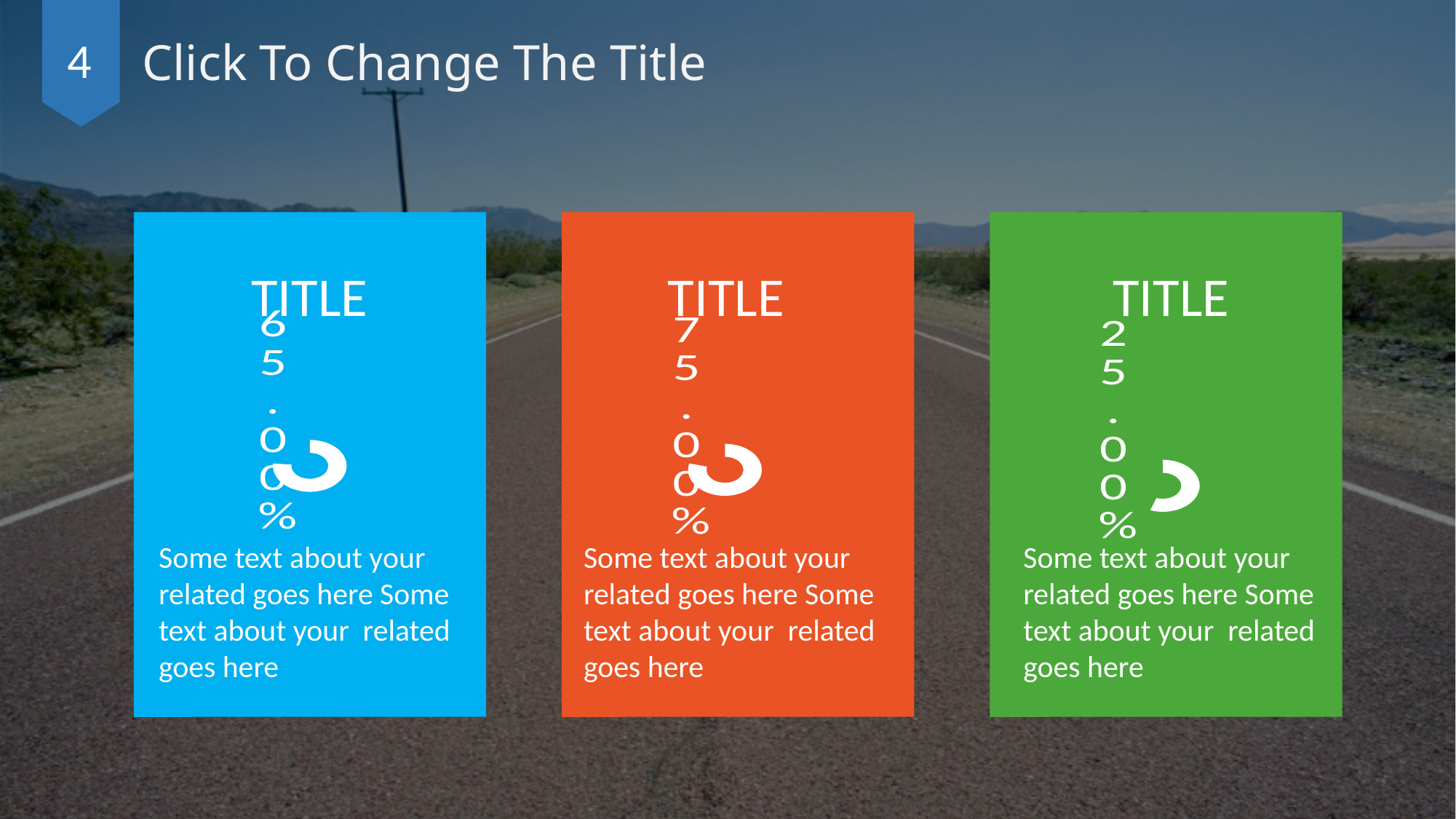
Which panel's chart shows the highest percentage? The middle (orange) panel What value is shown on the left (blue) panel's chart? 65.00% Which panel's chart shows the lowest percentage? The right (green) panel What colour is the background of the panel containing the 75.00% chart? Orange What is the difference between the middle (orange) panel's value and the left (blue) panel's value? 10.00% Is the value on the right (green) panel's chart greater or less than 50%? less What value is shown on the right (green) panel's chart? 25.00% What value is shown on the middle (orange) panel's chart? 75.00% How many charts are shown on the slide? 3 What is the difference between the middle (orange) panel's value and the right (green) panel's value? 50.00% What kind of chart is used in each panel? Doughnut chart Which is larger, the value on the left (blue) panel's chart or the value on the right (green) panel's chart? The left (blue) panel's chart